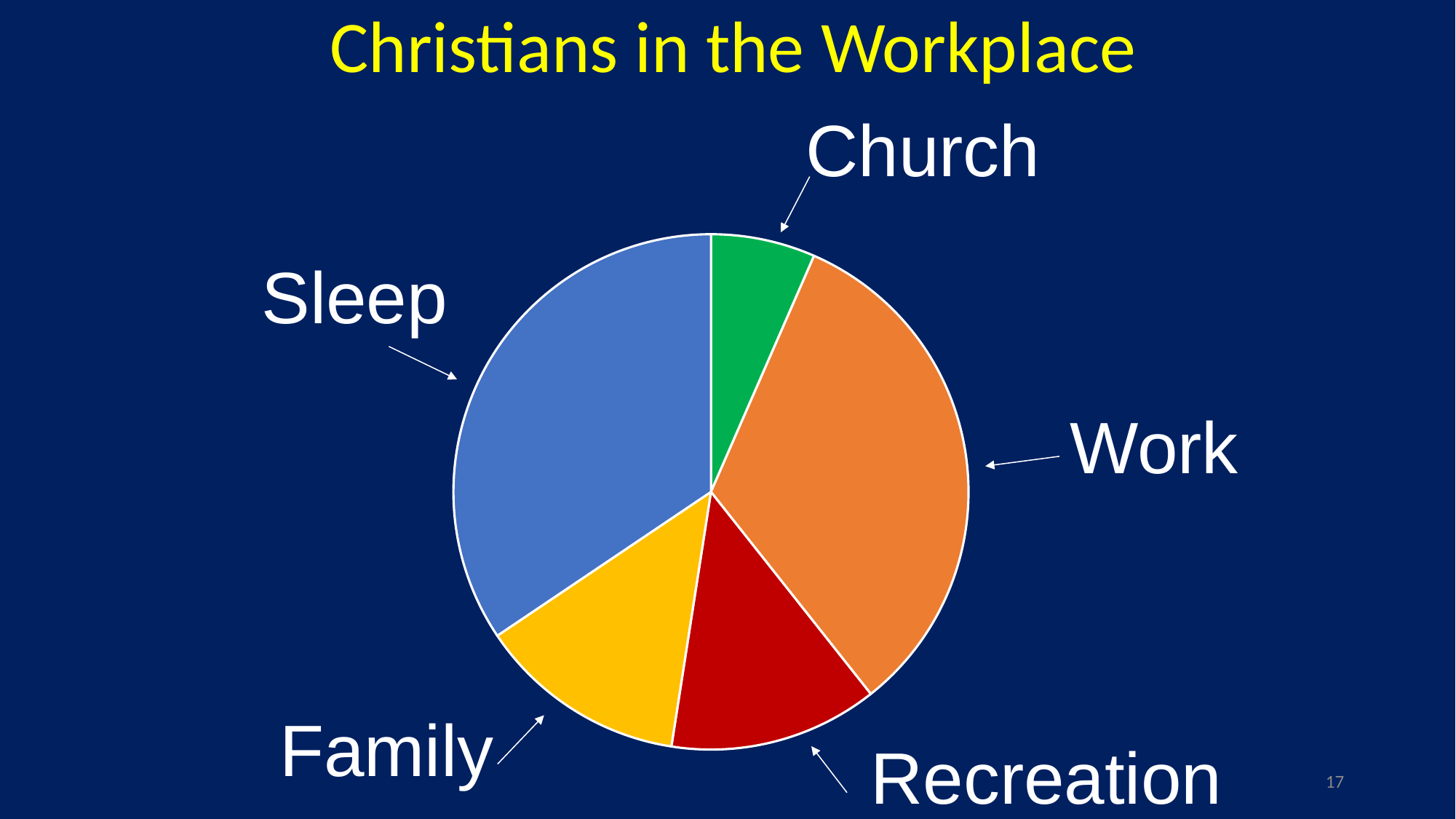
Which slice is larger, Sleep or Church? Sleep What kind of chart is shown on the slide? pie chart Which slice is larger, Recreation or Church? Recreation Which slice is larger, Work or Church? Work What is the title of the slide containing the pie chart? Christians in the Workplace How many slices does the pie chart have? 5 What colour is the Sleep slice of the pie chart? blue Which category has the smallest slice of the pie chart? Church